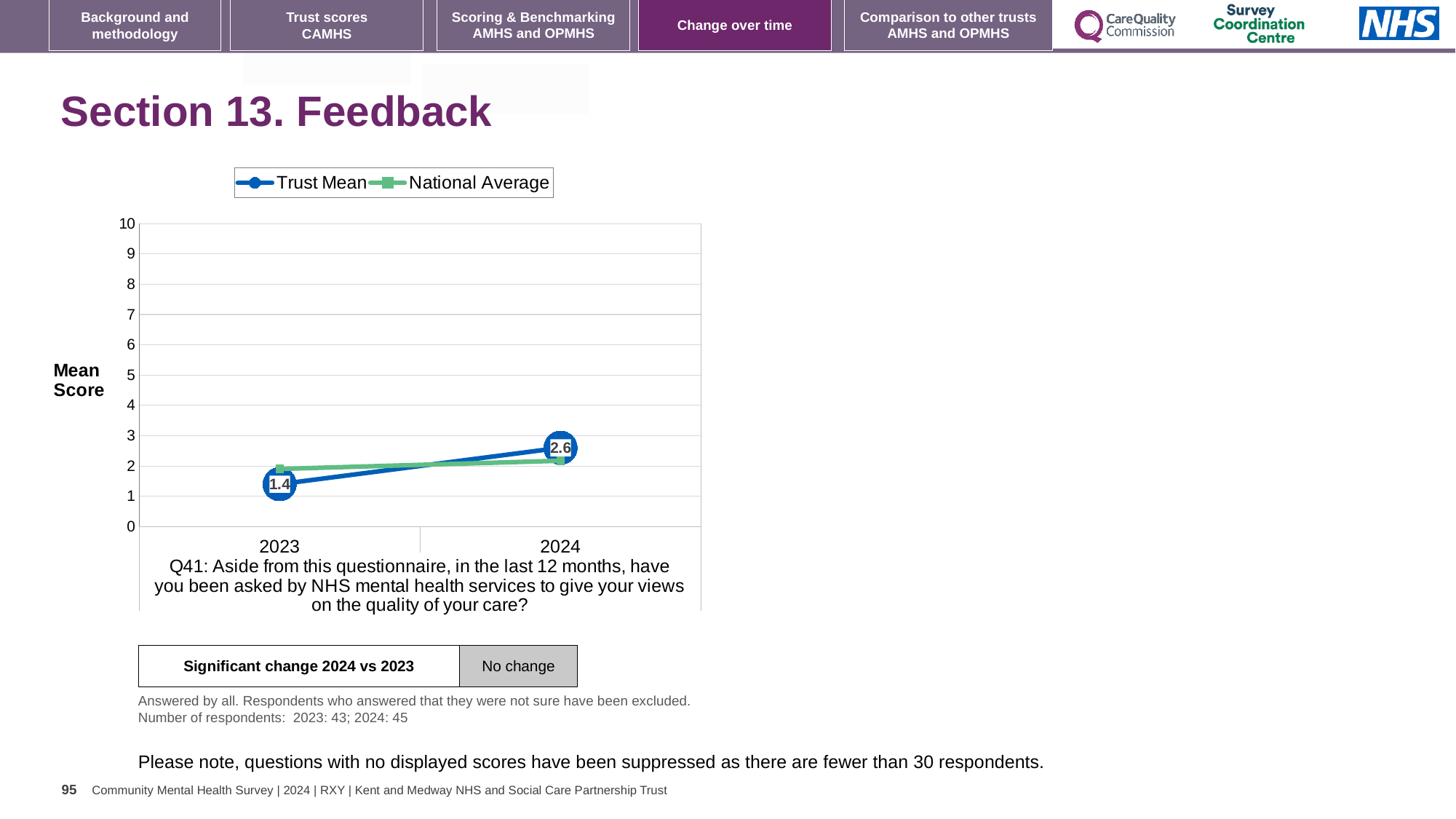
Is the National Average value for 2024 greater or less than 1? greater How many series does the legend list? 2 Does the Trust Mean rise or fall from 2023 to 2024? rise Which year has the higher Trust Mean score? 2024 What is the Trust Mean score for 2024? 2.6 Is the National Average value for 2023 greater or less than 3? less What kind of chart is shown on the slide? line chart In 2023, which is higher: the Trust Mean or the National Average? National Average By how much did the Trust Mean score change from 2023 to 2024? 1.2 In 2024, which is higher: the Trust Mean or the National Average? Trust Mean What is the Trust Mean score for 2023? 1.4 Which year has the lower Trust Mean score? 2023